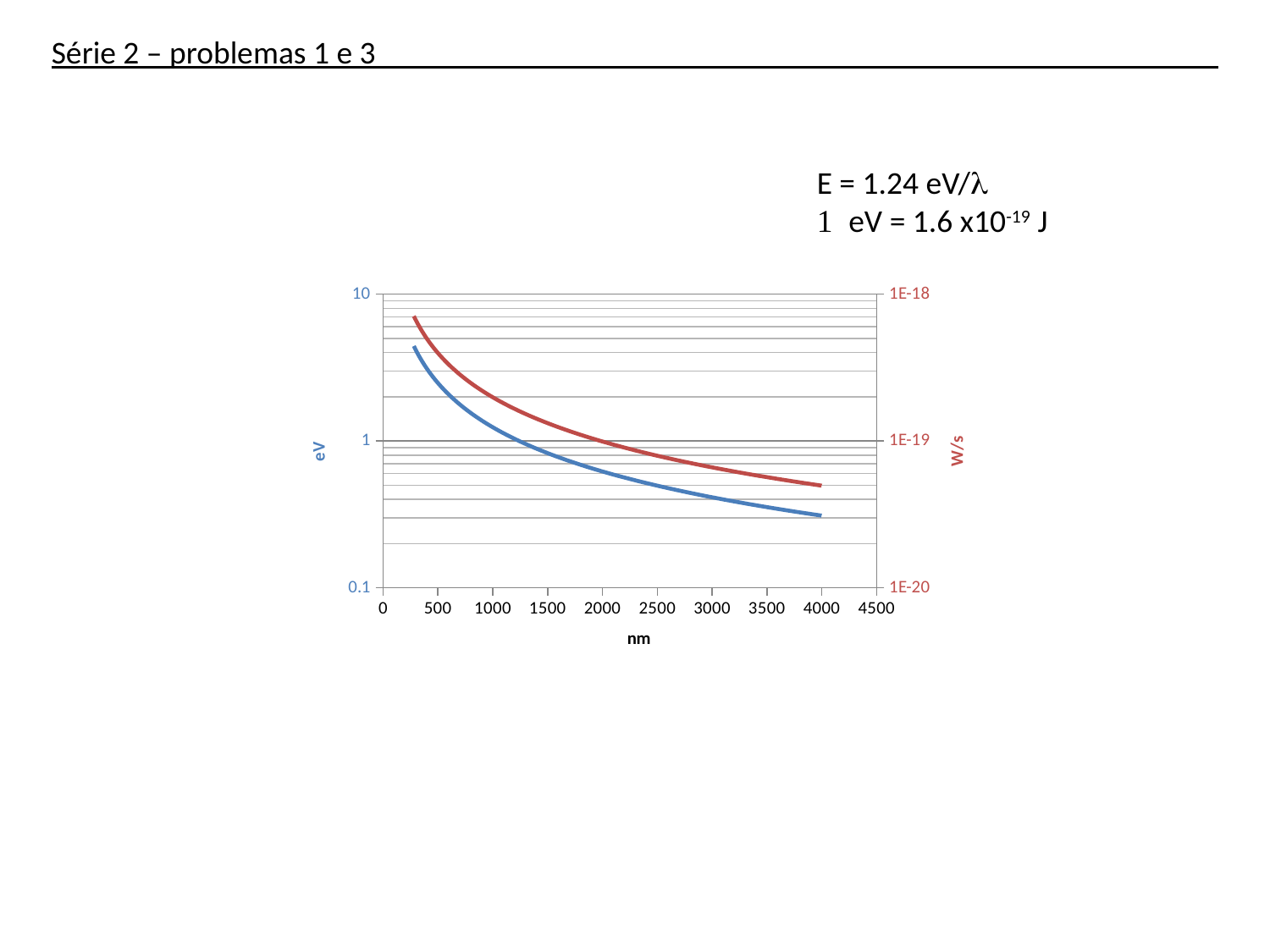
Is the value of the blue line at 500 nm greater or less than 1 eV? greater What is the label of the left vertical axis? eV Is the value of the blue line at 2000 nm greater or less than 1 eV? less Is the value of the red line at 500 nm greater or less than 1E-19 W/s? greater What is the label of the right vertical axis? W/s How many lines are plotted on the chart? 2 Does the blue line rise or fall as the value in nm increases? fall What kind of chart is shown on the slide? line chart Does the red line rise or fall as the value in nm increases? fall